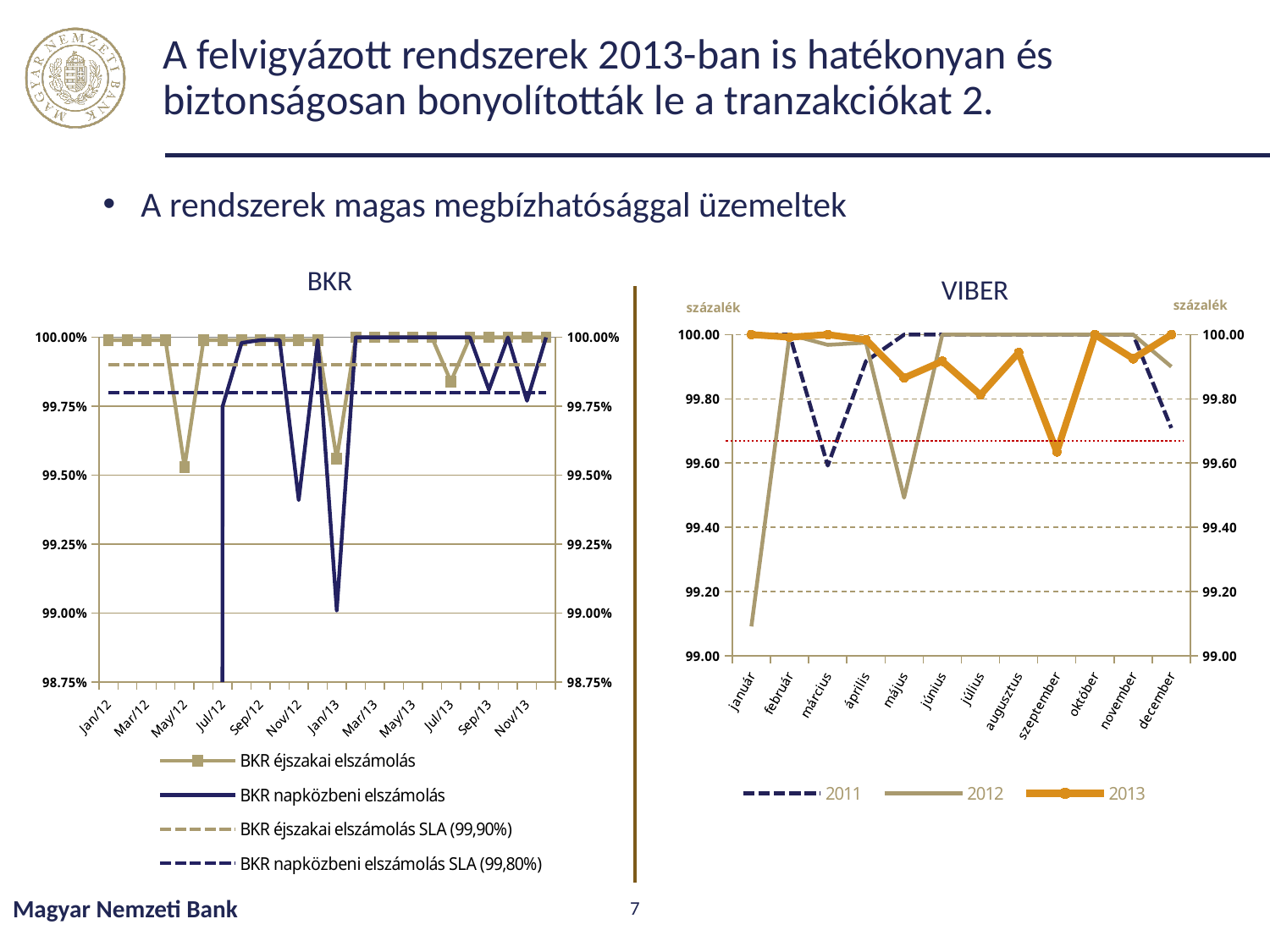
In the VIBER chart, is the value for 2011 in december greater or less than 99.80? less In the BKR chart, at which month does the BKR napközbeni elszámolás series reach its lowest value? Jan/13 How many series does the legend of the VIBER chart list? 3 How many series does the legend of the BKR chart list? 4 In the BKR chart, is the value of BKR napközbeni elszámolás in Nov/12 greater or less than 99.50%? less In the VIBER chart, is the value for 2012 in január greater or less than 99.20? less How many months are shown on the x axis of the VIBER chart? 12 In the VIBER chart, which month has the lowest value for the 2012 series? január What kind of chart is the VIBER chart? line chart In the VIBER chart, which month has the lowest value for the 2013 series? szeptember In the BKR chart, what SLA level does the legend give for BKR éjszakai elszámolás? 99,90%